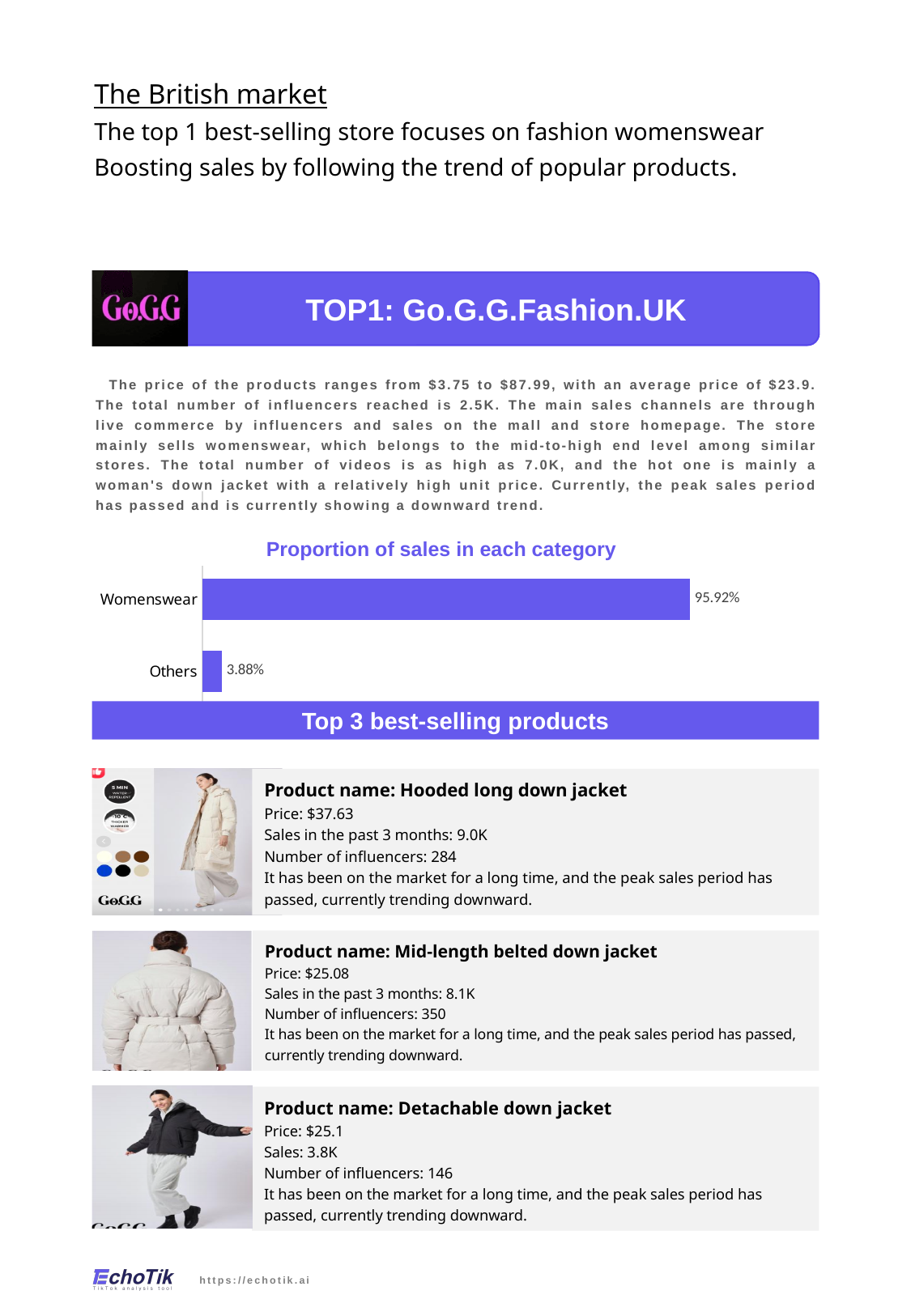
What is the difference between the Womenswear and Others values in the 'Proportion of sales in each category' chart? 92.04% Are the bars in the 'Proportion of sales in each category' chart horizontal or vertical? Horizontal Which category has the highest proportion of sales in the chart? Womenswear Which is larger in the chart, the value for Womenswear or the value for Others? Womenswear Which category has the lowest proportion of sales in the chart? Others What is the title of the chart on the slide? Proportion of sales in each category What is the value for Others in the 'Proportion of sales in each category' chart? 3.88% How many categories are shown in the 'Proportion of sales in each category' chart? 2 What is the value for Womenswear in the 'Proportion of sales in each category' chart? 95.92% What kind of chart is used to show the proportion of sales in each category? Bar chart